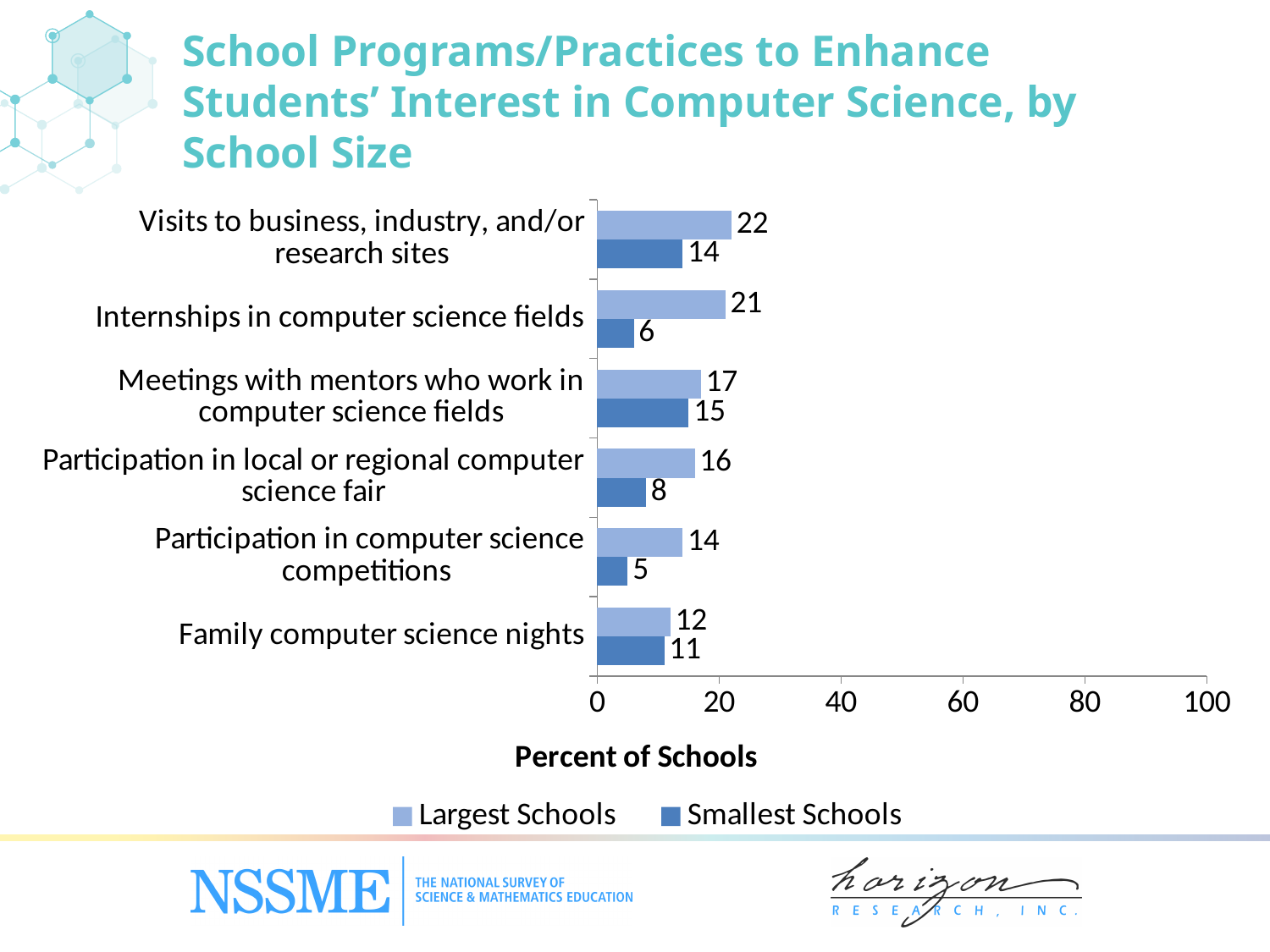
What kind of chart is shown on the slide? Bar chart For meetings with mentors who work in computer science fields, which series has the larger value, Largest Schools or Smallest Schools? Largest Schools Which program has the highest value for Largest Schools? Visits to business, industry, and/or research sites How many program categories are shown on the chart? 6 Is the value for Largest Schools for participation in local or regional computer science fair greater or less than 20? less What is the difference between Largest Schools and Smallest Schools for internships in computer science fields? 15 What is the value for Smallest Schools for family computer science nights? 11 What percent of the largest schools offer visits to business, industry, and/or research sites? 22 What is the label of the horizontal axis? Percent of Schools Which program has the lowest value for Smallest Schools? Participation in computer science competitions What percent of the smallest schools offer internships in computer science fields? 6 How many series does the legend list? 2